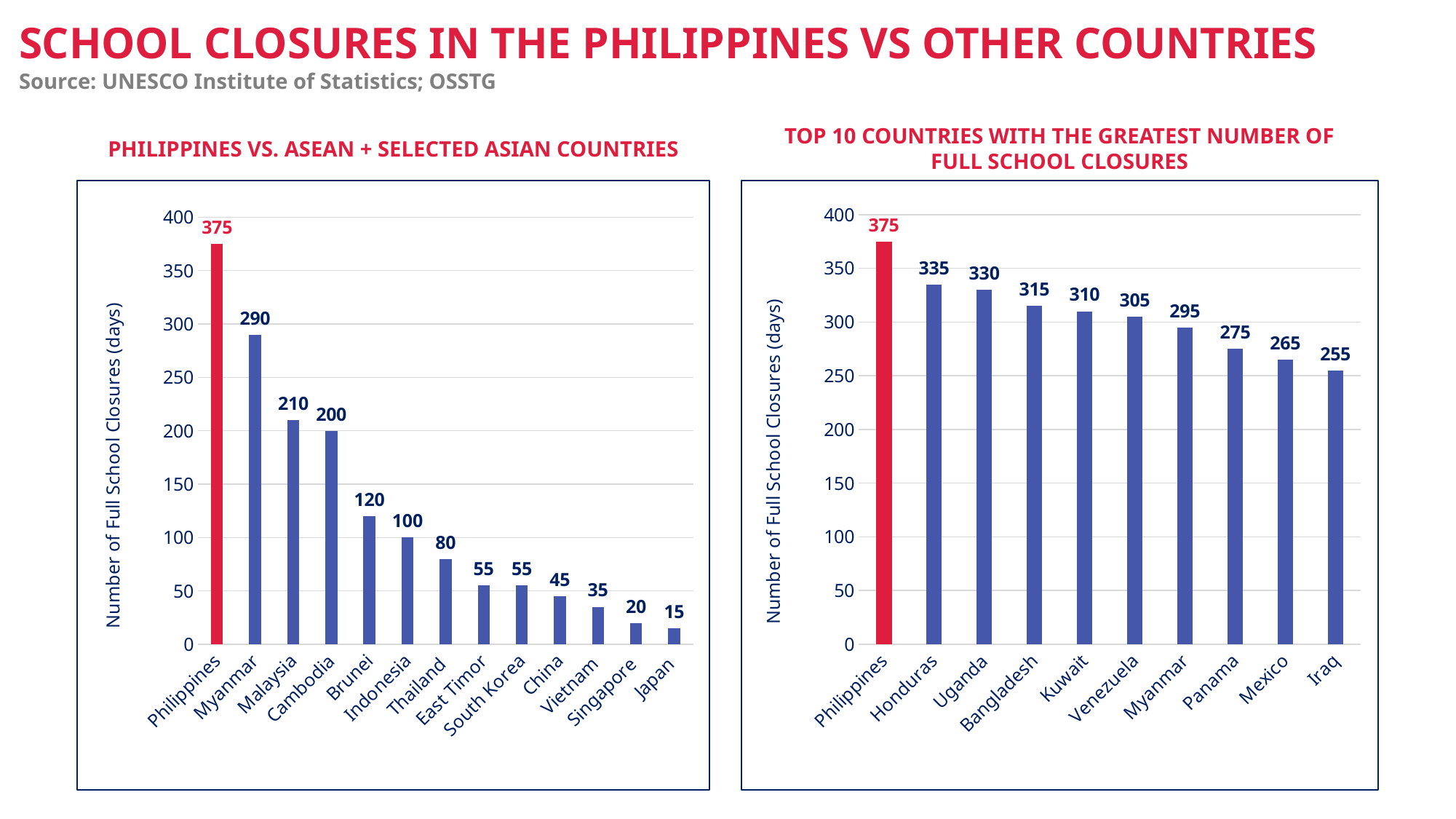
In the 'Philippines vs. ASEAN + Selected Asian Countries' chart, what is the number of full school closure days for Myanmar? 290 In the 'Top 10 Countries with the Greatest Number of Full School Closures' chart, do the values rise or fall from left to right along the x axis? fall In the 'Top 10 Countries with the Greatest Number of Full School Closures' chart, what is the difference between Honduras and Iraq? 80 In the 'Top 10 Countries with the Greatest Number of Full School Closures' chart, which country has the highest number of full school closure days? Philippines In the 'Philippines vs. ASEAN + Selected Asian Countries' chart, how many countries are shown? 13 In the 'Philippines vs. ASEAN + Selected Asian Countries' chart, which has more full school closure days, Brunei or Indonesia? Brunei In the 'Top 10 Countries with the Greatest Number of Full School Closures' chart, which bar is coloured red? Philippines In the 'Philippines vs. ASEAN + Selected Asian Countries' chart, which country has the lowest number of full school closure days? Japan In the 'Philippines vs. ASEAN + Selected Asian Countries' chart, what is the difference in full school closure days between the Philippines and Malaysia? 165 What kind of chart is the 'Top 10 Countries with the Greatest Number of Full School Closures' chart? bar chart In the 'Philippines vs. ASEAN + Selected Asian Countries' chart, what is the value for Vietnam? 35 In the 'Top 10 Countries with the Greatest Number of Full School Closures' chart, what is the value for Kuwait? 310